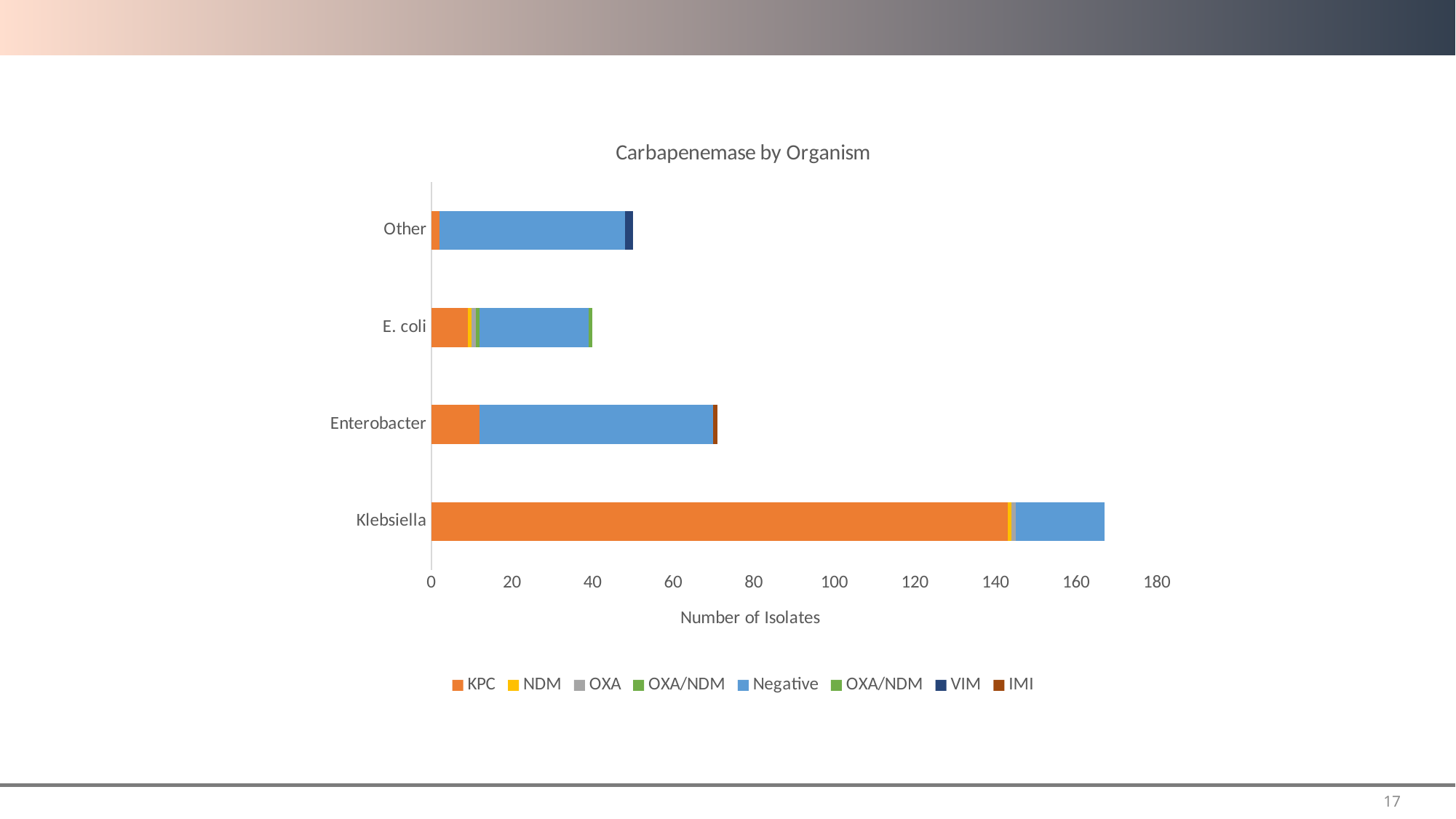
What is the title of the chart? Carbapenemase by Organism How many series does the legend list? 8 Which has a larger total number of isolates, Other or E. coli? Other Is the total number of isolates for Enterobacter greater or less than 60? greater Which organism has the longest total bar? Klebsiella Is the total number of isolates for Klebsiella greater or less than 160? greater What type of chart is shown on the slide? Stacked bar chart How many organism categories are shown on the chart? 4 Is the KPC value for Enterobacter greater or less than 20? less Which organism has the shortest total bar? E. coli What is the label of the x axis? Number of Isolates